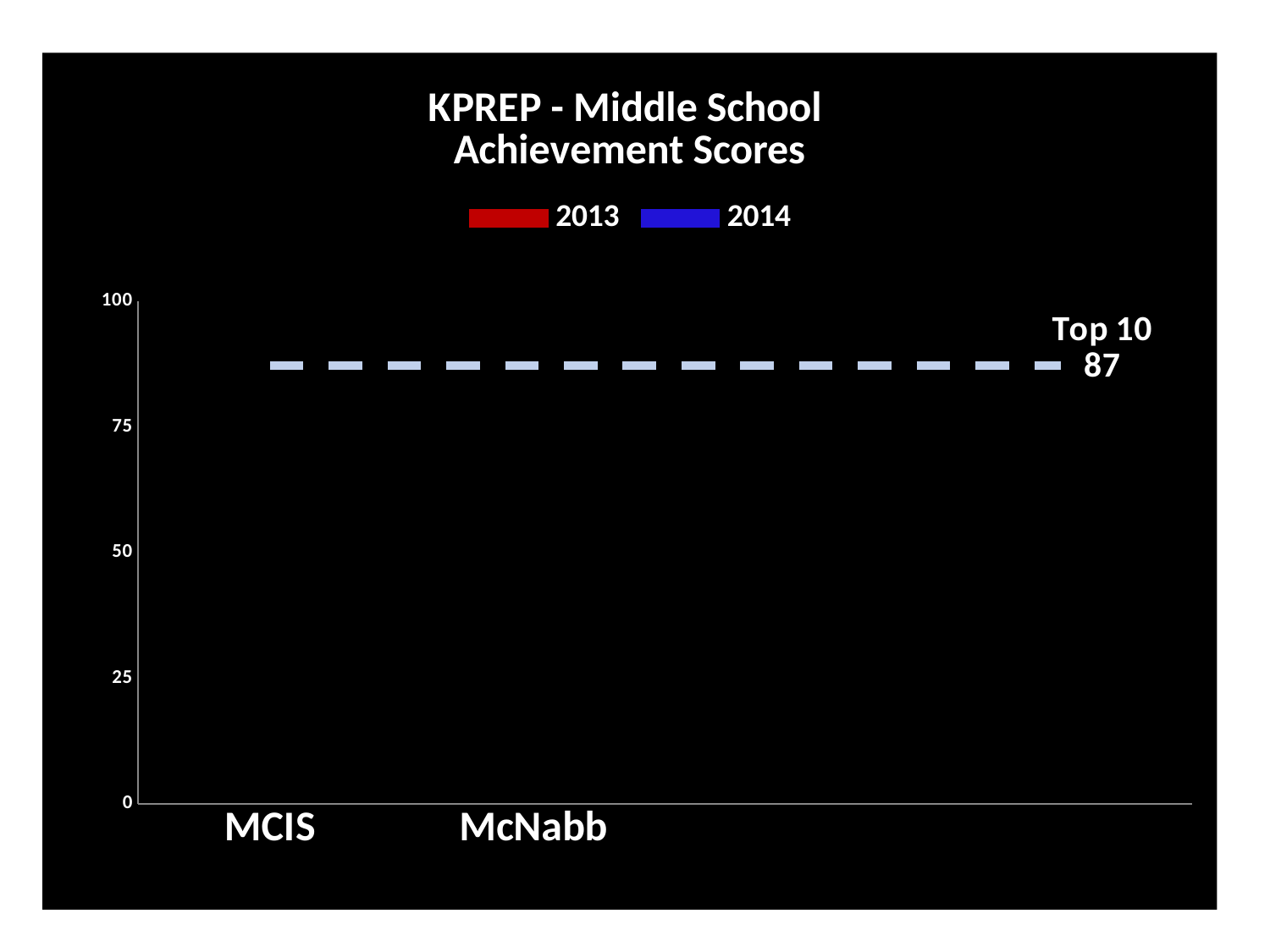
Is the 'Top 10' reference line greater or less than 75 on the y axis? greater What is the maximum value shown on the y axis? 100 Which two series are listed in the legend? 2013 and 2014 How many series does the legend list? 2 What is the title of the chart? KPREP - Middle School Achievement Scores How many categories are labeled on the x axis? 2 What value is the dashed 'Top 10' reference line labeled with? 87